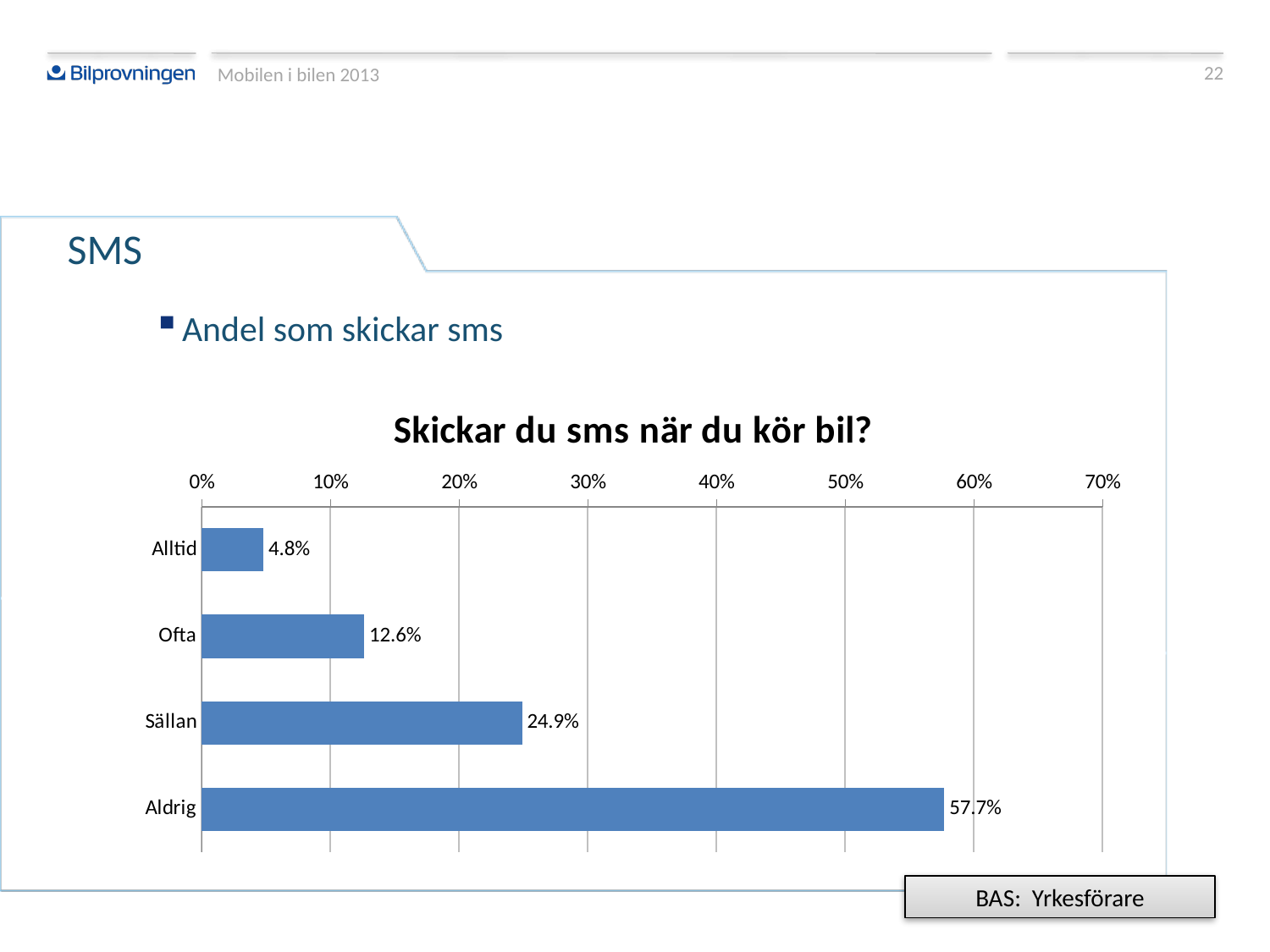
What is the difference between the values for Aldrig and Sällan? 32.8% Which category has the lowest value? Alltid Is the value for Aldrig greater or less than 50%? greater Which category has the highest value? Aldrig How many categories are shown in the chart? 4 What kind of chart is shown on the slide? bar chart What is the value for Alltid? 4.8% What is the value for Ofta? 12.6% What is the value for Sällan? 24.9% What is the title of the chart? Skickar du sms när du kör bil? What is the value for Aldrig? 57.7% Which is larger, the value for Ofta or the value for Sällan? Sällan